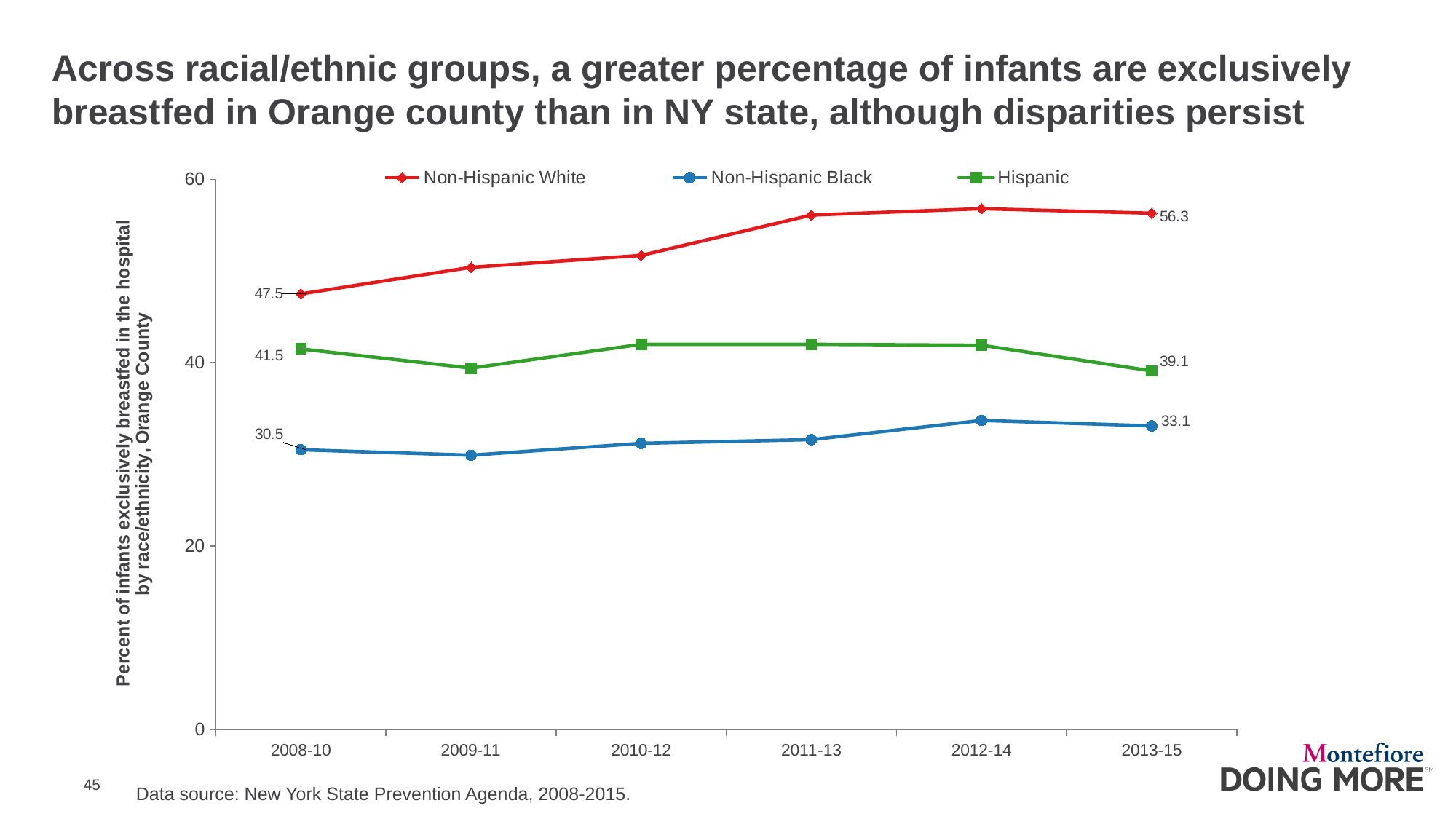
What is the value for Non-Hispanic Black in 2008-10? 30.5 Is the value for Non-Hispanic Black in 2012-14 greater or less than 40? less What is the difference between the Non-Hispanic White value in 2013-15 and in 2008-10? 8.8 How many series does the legend list? 3 Which series has the lowest value in 2008-10? Non-Hispanic Black What is the value for Hispanic in 2013-15? 39.1 What is the value for Non-Hispanic White in 2013-15? 56.3 Which is larger in 2013-15: the Hispanic value or the Non-Hispanic Black value? Hispanic How many time periods are shown on the x axis? 6 What is the value for Non-Hispanic White in 2008-10? 47.5 Which series has the highest value in 2013-15? Non-Hispanic White What kind of chart is shown on the slide? line chart